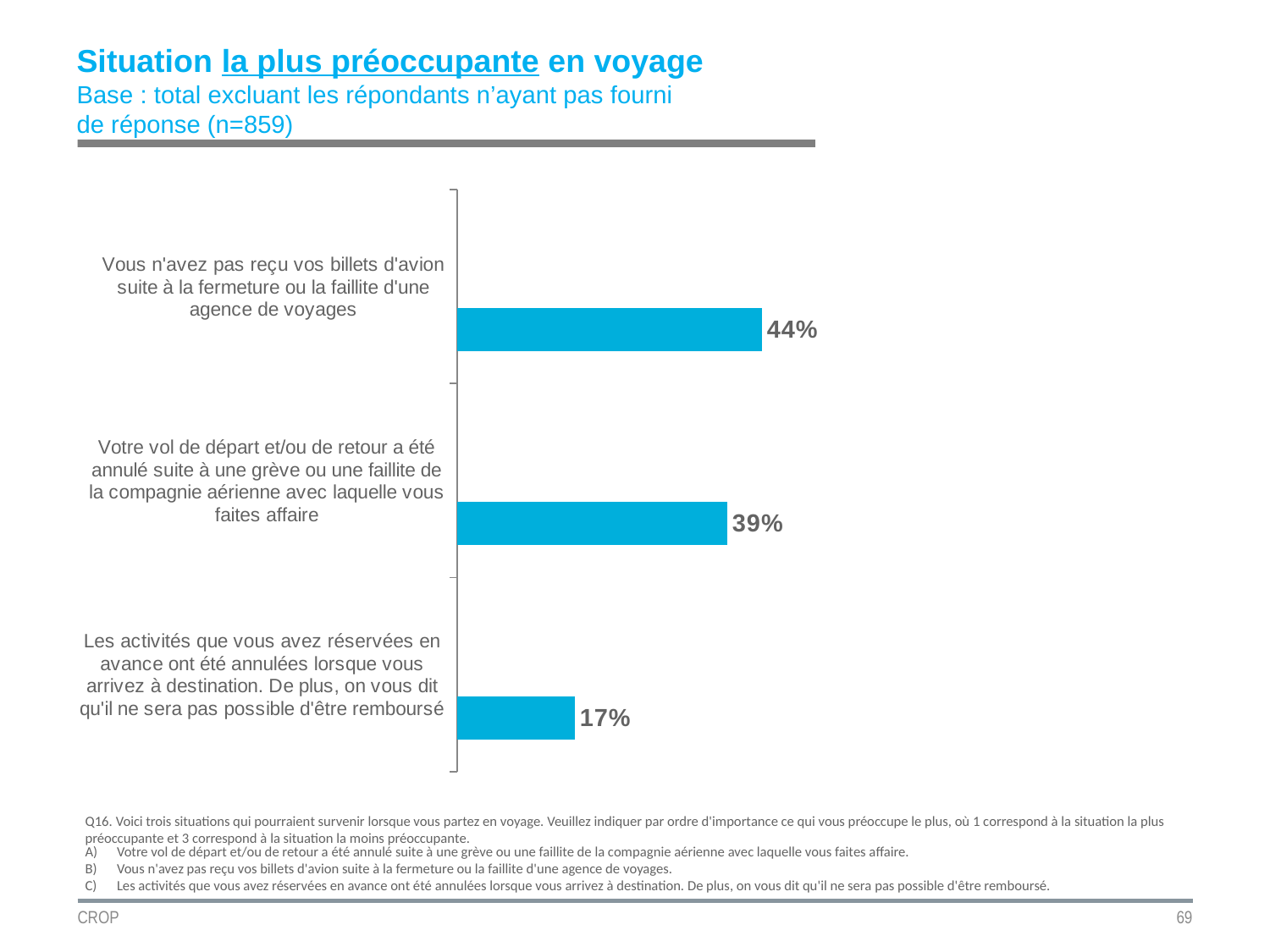
What is the base size (n) indicated in the slide subtitle? n=859 What is the total of the three percentages shown in the chart? 100% What type of chart is shown on the slide? Bar chart How many situations (categories) are shown in the chart? 3 Which is larger: the value for the cancelled flight situation or the value for the cancelled activities situation? Cancelled flight situation (39%) What percentage is shown for activities booked in advance being cancelled on arrival with no refund possible? 17% What is the difference in percentage points between the cancelled flight situation and the cancelled activities situation? 22 Which situation has the highest percentage? Vous n'avez pas reçu vos billets d'avion suite à la fermeture ou la faillite d'une agence de voyages What is the value for the situation where the departure and/or return flight is cancelled due to a strike or airline bankruptcy? 39% What is the difference in percentage points between the travel agency bankruptcy situation and the cancelled flight situation? 5 Which situation has the lowest percentage? Les activités que vous avez réservées en avance ont été annulées lorsque vous arrivez à destination. De plus, on vous dit qu'il ne sera pas possible d'être remboursé What percentage of respondents chose not receiving plane tickets due to the closure or bankruptcy of a travel agency as the most worrying situation? 44%